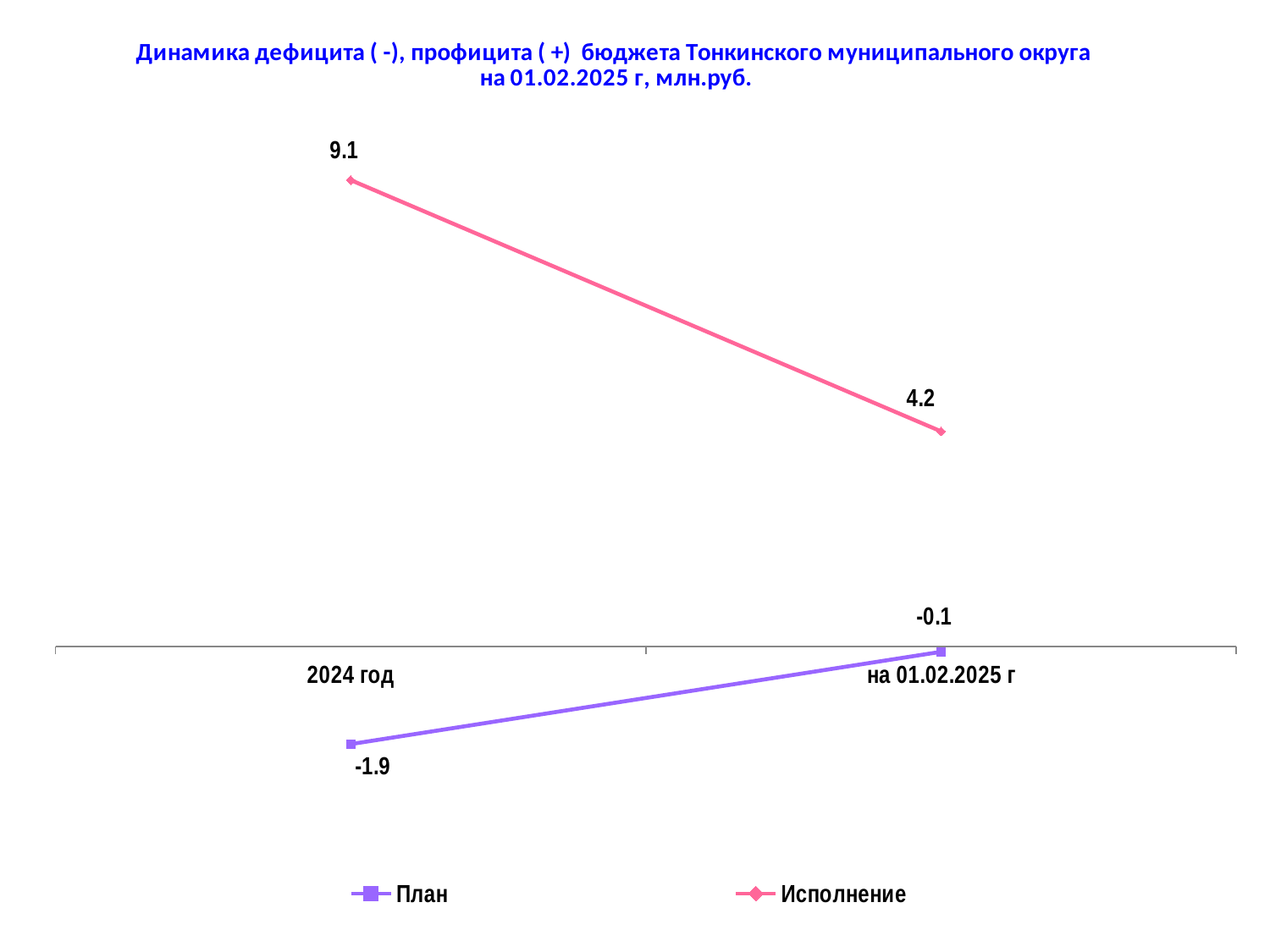
What kind of chart is shown on the slide? Line chart What is the value of the План series for на 01.02.2025 г? -0.1 What is the value of the Исполнение series for 2024 год? 9.1 What is the value of the Исполнение series for на 01.02.2025 г? 4.2 What is the difference between the Исполнение values for 2024 год and на 01.02.2025 г? 4.9 Does the Исполнение series rise or fall from 2024 год to на 01.02.2025 г? Fall Which category has the highest value for the Исполнение series? 2024 год How many series does the legend list? 2 How many categories are shown on the x axis? 2 Which is larger for 2024 год: the План value or the Исполнение value? Исполнение What is the value of the План series for 2024 год? -1.9 Which category has the lowest value for the План series? 2024 год